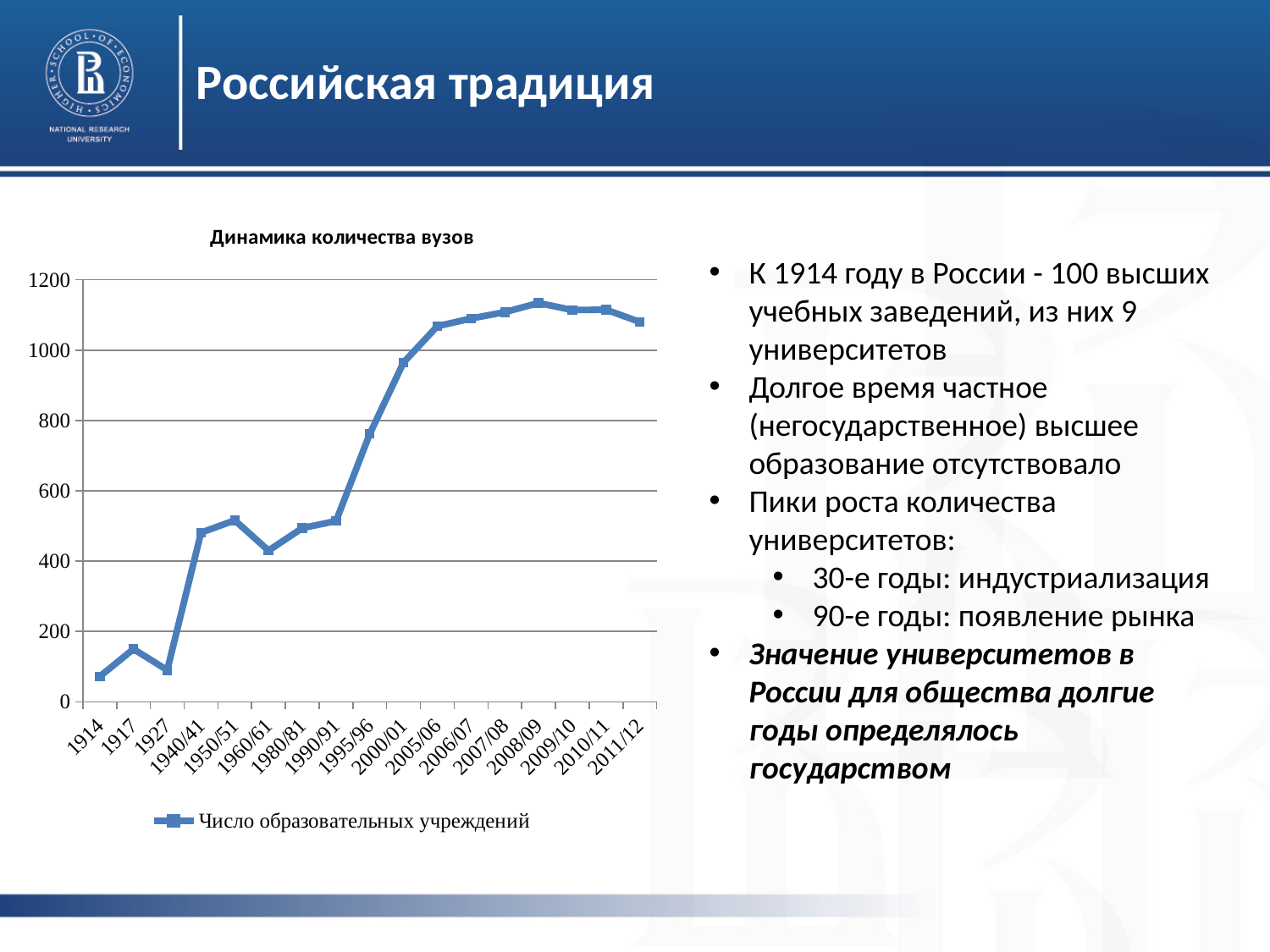
What kind of chart is shown on the slide? line chart How many points (years) are plotted along the x axis of the chart? 17 Is the value for 1914 greater or less than 200? less Overall, does the number of educational institutions rise or fall from 1914 to 2011/12? rise Is the value for 1940/41 greater or less than 400? greater How many series does the chart legend list? 1 What is the title of the chart? Динамика количества вузов In which year does the number of educational institutions reach its highest value? 2008/09 Which is larger, the value for 1950/51 or the value for 1960/61? 1950/51 What is the name of the series shown in the chart legend? Число образовательных учреждений Is the value for 1995/96 greater or less than 600? greater